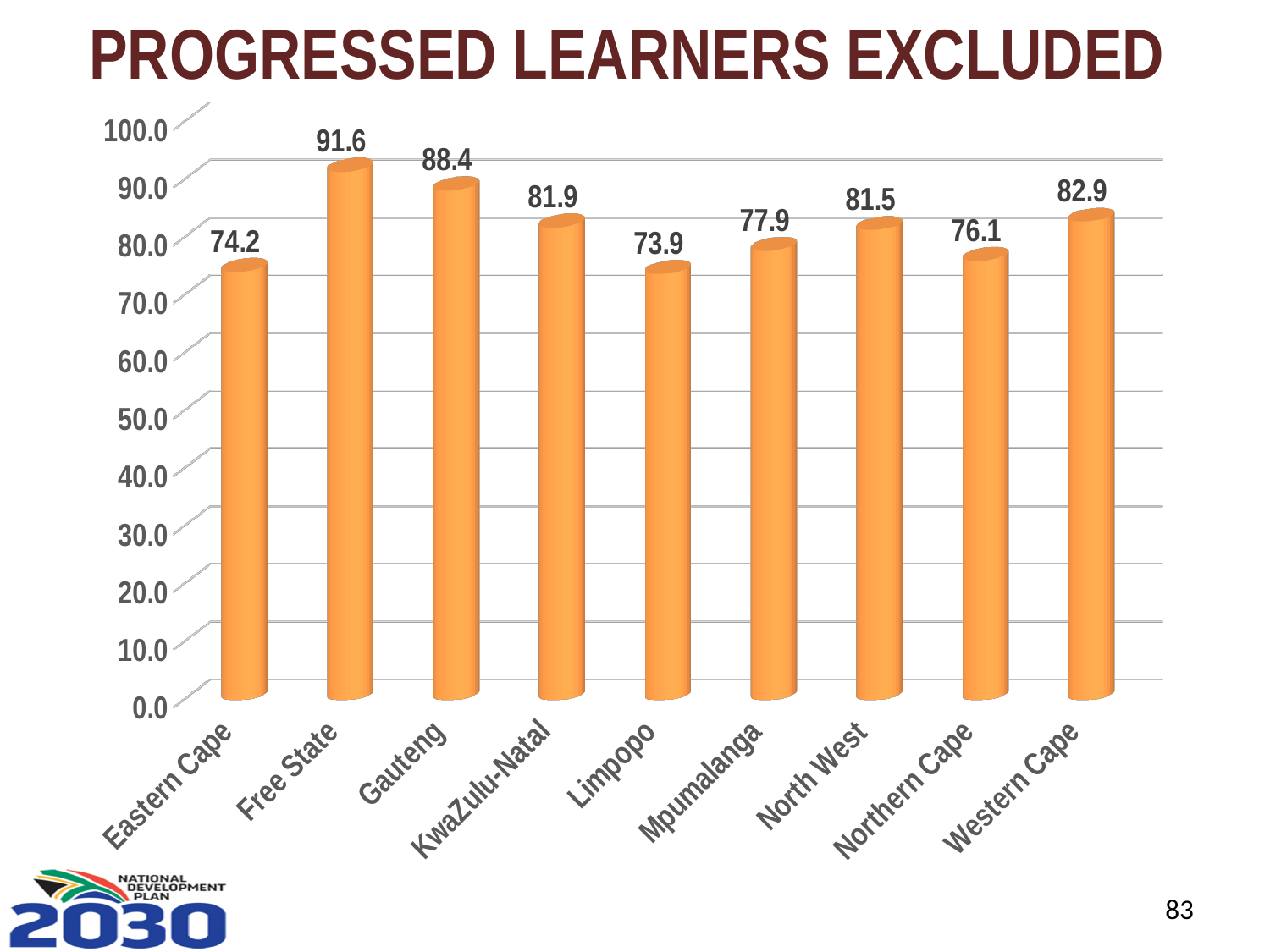
Is the value for Gauteng greater or less than 80.0? greater What is the value for Free State? 91.6 How many provinces are shown on the chart? 9 Which province has the highest value? Free State What is the value for Limpopo? 73.9 What kind of chart is shown on the slide? bar chart Which is larger, the value for Mpumalanga or the value for Northern Cape? Mpumalanga What is the value for Western Cape? 82.9 What is the difference between the values for Western Cape and Eastern Cape? 8.7 What is the difference between the values for Free State and Gauteng? 3.2 What is the title of the chart? PROGRESSED LEARNERS EXCLUDED Which province has the lowest value? Limpopo